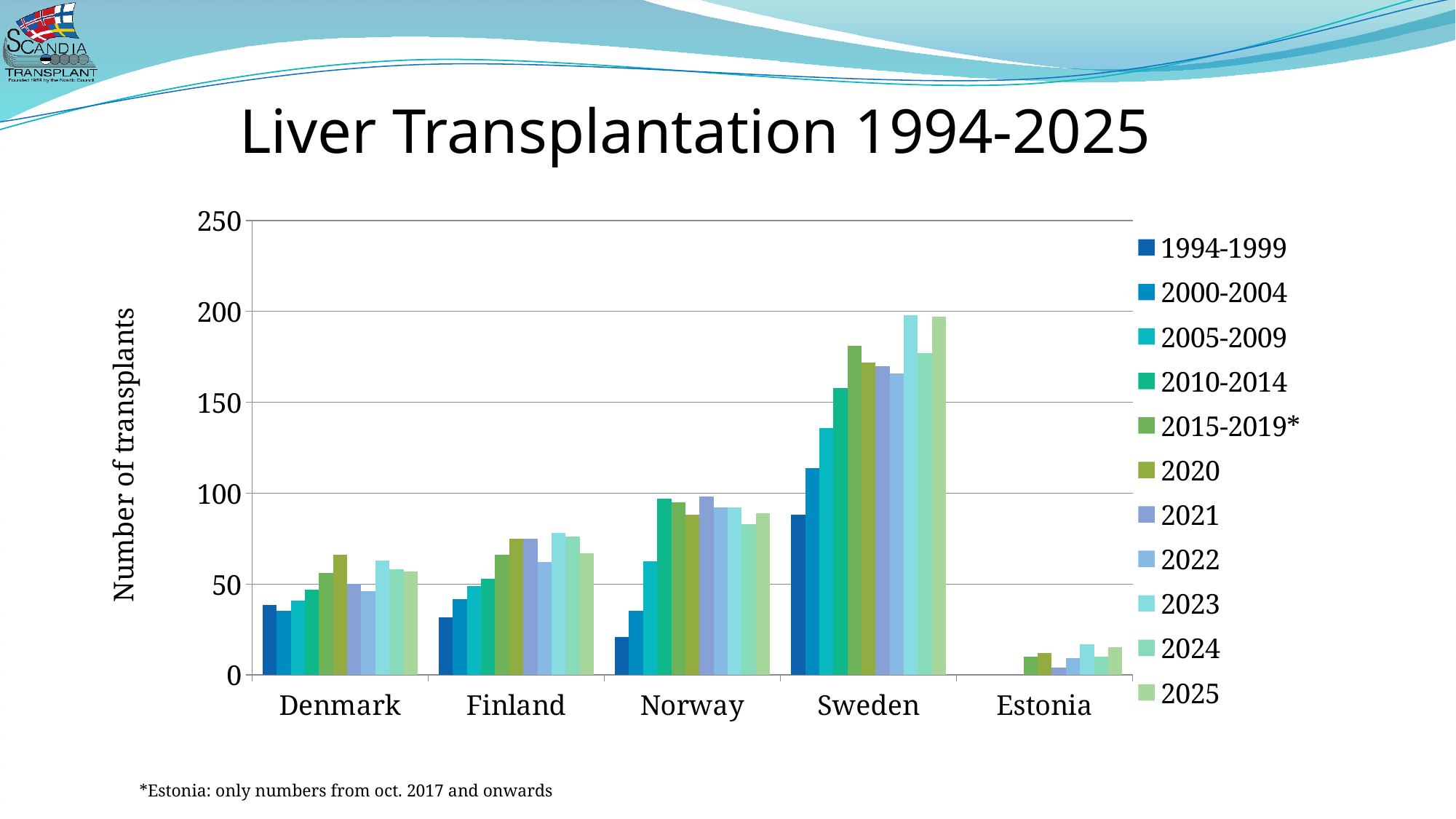
How many countries are shown on the x axis? 5 How many series does the legend list? 11 What is the label on the y axis? Number of transplants Which is larger for the 2015-2019* series: Sweden or Norway? Sweden Is the value for Denmark in 1994-1999 greater or less than 50? less Which country has the highest value for the 2023 series? Sweden Do Sweden's values rise or fall from 1994-1999 through 2015-2019*? rise What kind of chart is shown on the slide? bar chart Is the value for Norway in 2021 greater or less than 50? greater Is the value for Sweden in 2023 greater or less than 150? greater Which country has the lowest value for the 2023 series? Estonia Which is larger for the 2020 series: Finland or Denmark? Finland